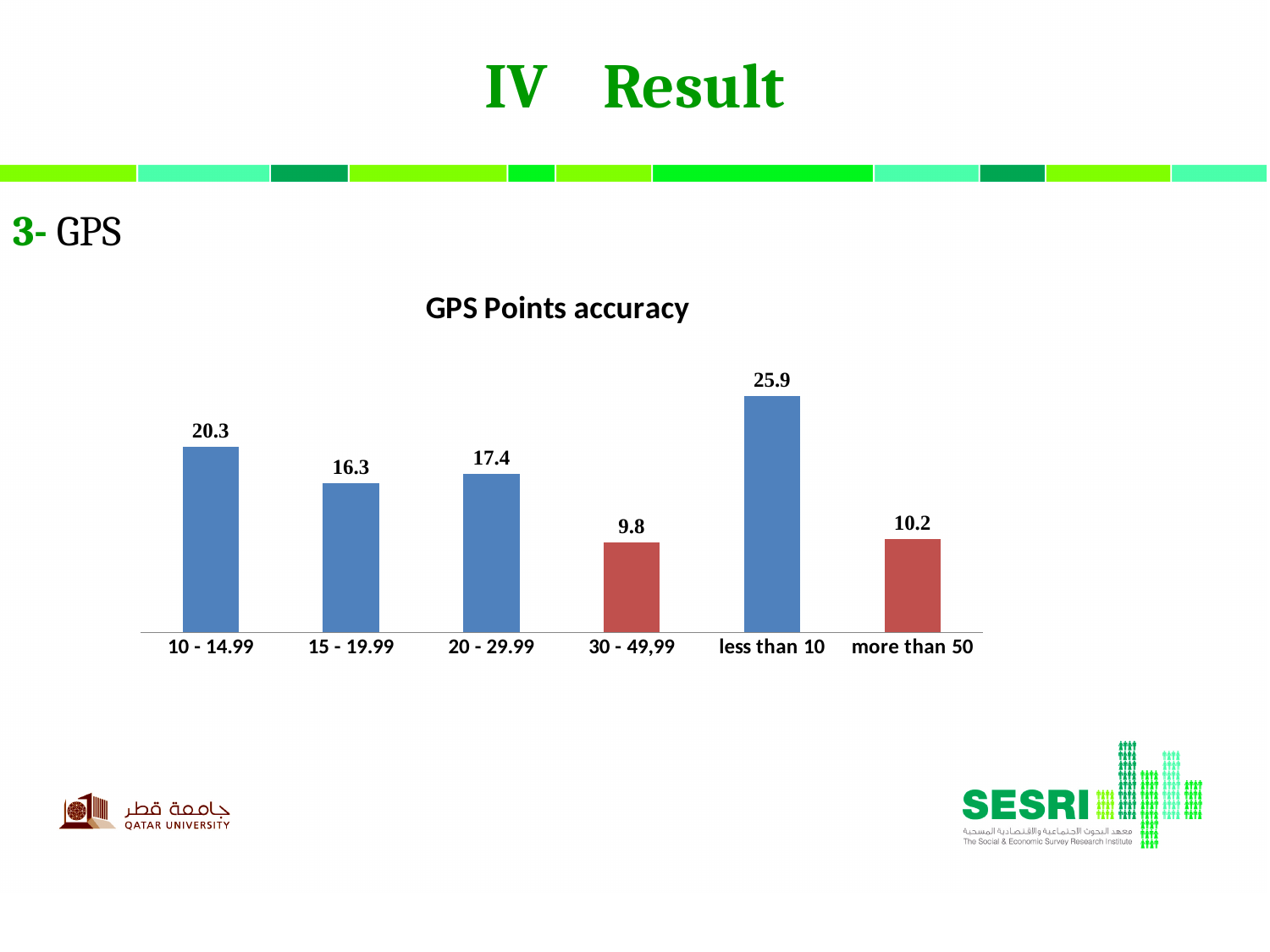
What is the difference between the values for "20 - 29.99" and "15 - 19.99"? 1.1 What is the value for the "30 - 49,99" category? 9.8 What kind of chart is shown on the slide? Bar chart Which is larger, the value for "15 - 19.99" or the value for "20 - 29.99"? 20 - 29.99 What is the difference between the values for "less than 10" and "10 - 14.99"? 5.6 How many categories are shown in the chart? 6 What is the value for the "10 - 14.99" category? 20.3 Which category has the highest value? less than 10 What is the title of the chart? GPS Points accuracy What is the value for the "less than 10" category in the GPS Points accuracy chart? 25.9 Which category has the lowest value? 30 - 49,99 What is the value for the "more than 50" category? 10.2